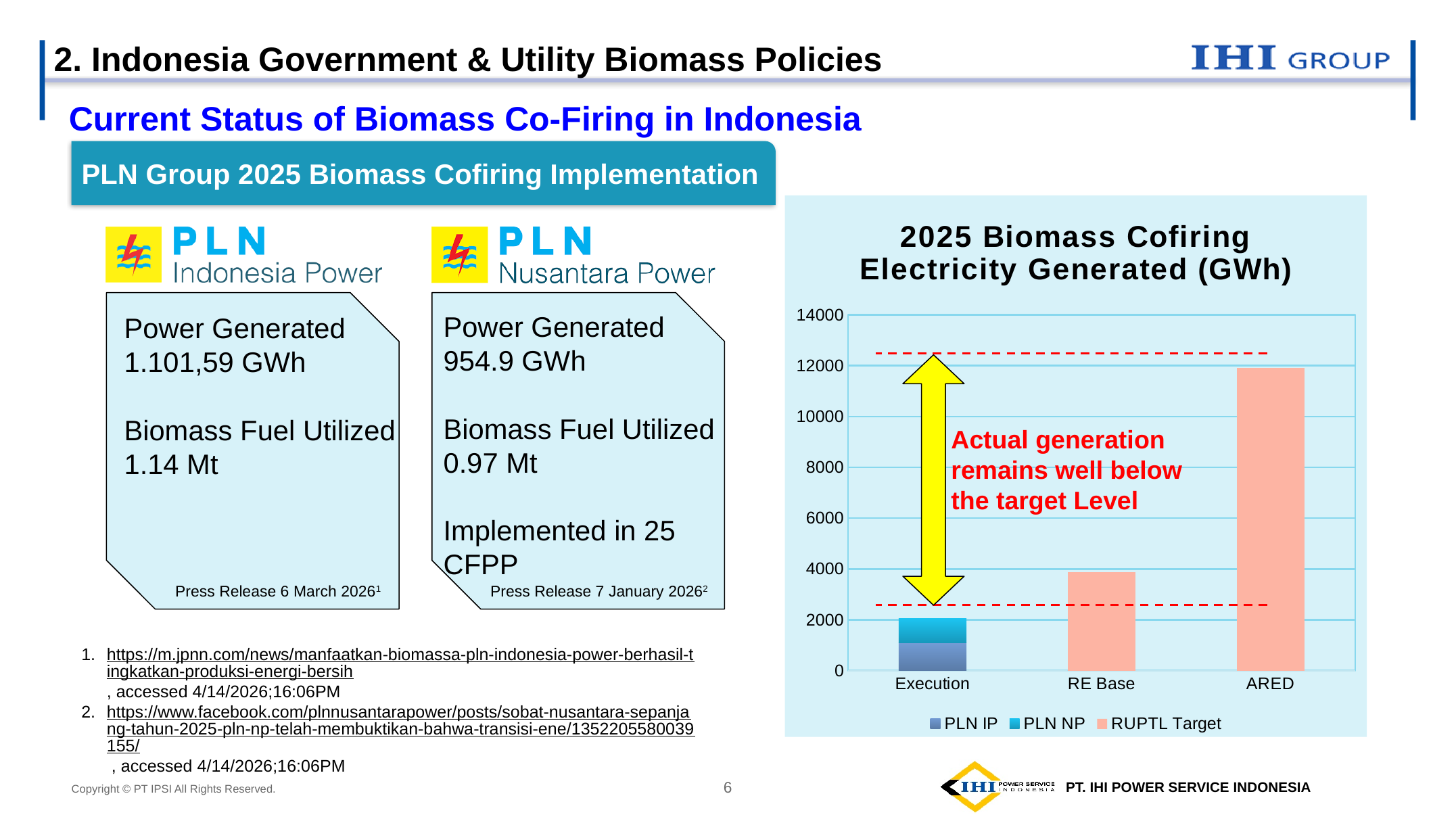
How many series does the chart legend list? 3 What kind of chart is shown on the slide? bar chart How many categories are shown on the x axis of the chart? 3 What is the title of the chart? 2025 Biomass Cofiring Electricity Generated (GWh) Which series are listed in the chart legend? PLN IP, PLN NP, RUPTL Target Is the value for RE Base greater or less than 2000? greater Is the total of the Execution bar greater or less than 4000? less Which category has the lowest bar in the chart? Execution Which is larger, the bar for RE Base or the bar for ARED? ARED Which category has the highest bar in the chart? ARED Is the value for ARED greater or less than 10000? greater Do the bar values rise or fall from Execution to ARED along the x axis? rise